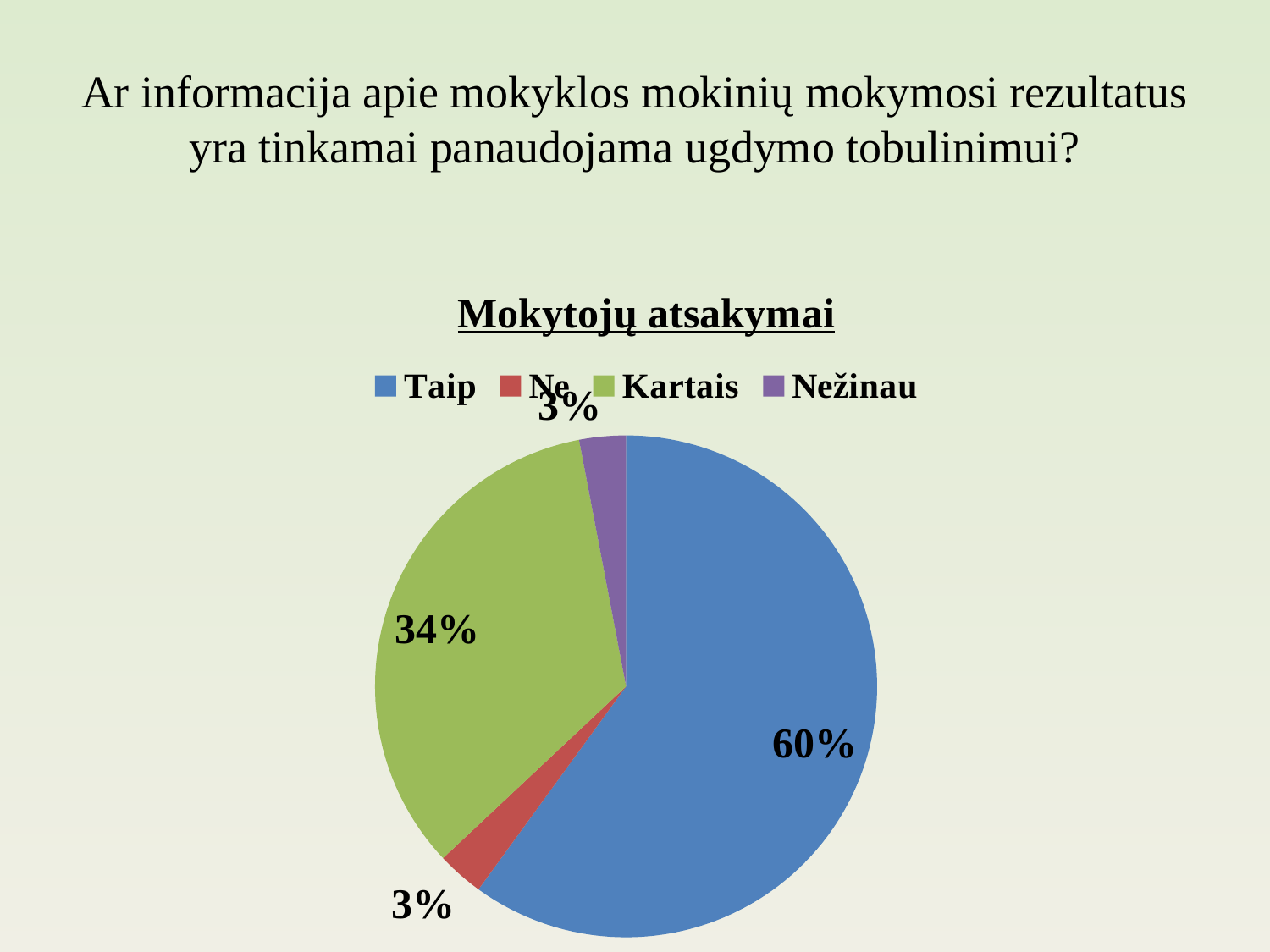
What is the title of the chart? Mokytojų atsakymai What percentage of the pie is the 'Kartais' slice? 34% Is the share for 'Taip' greater or less than 50%? greater What colour is the 'Kartais' slice? green What is the difference in percentage points between the 'Taip' and 'Kartais' slices? 26 Which category has the largest slice of the pie? Taip How many categories does the legend list? 4 What percentage of the pie is the 'Taip' slice? 60% What percentage of the pie is the 'Ne' slice? 3% What percentage of the pie is the 'Nežinau' slice? 3% What kind of chart is shown on the slide? pie chart Which slice is larger, 'Kartais' or 'Ne'? Kartais